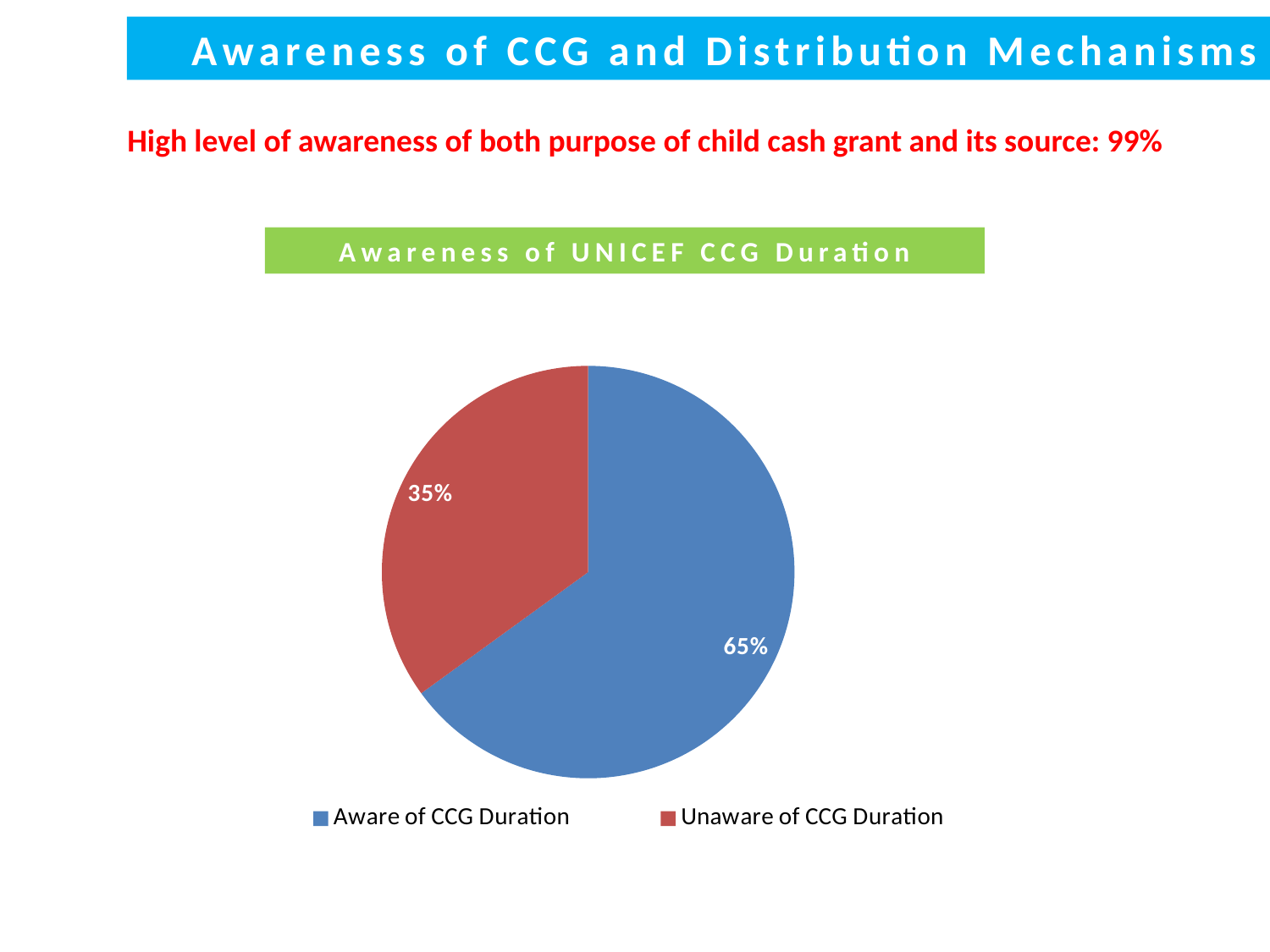
What is the total of the two slices shown in the pie chart? 100% How many slices does the pie chart have? 2 What colour is the Unaware of CCG Duration slice? Red What is the difference in percentage points between the Aware of CCG Duration and Unaware of CCG Duration slices? 30 What share of the pie is labelled Unaware of CCG Duration? 35% What kind of chart is shown on the slide? Pie chart How many entries does the legend list? 2 Which slice of the pie is the smallest? Unaware of CCG Duration What is the title of the chart? Awareness of UNICEF CCG Duration What share of the pie is labelled Aware of CCG Duration? 65% Which slice of the pie is the largest? Aware of CCG Duration Which is larger: the Aware of CCG Duration slice or the Unaware of CCG Duration slice? Aware of CCG Duration